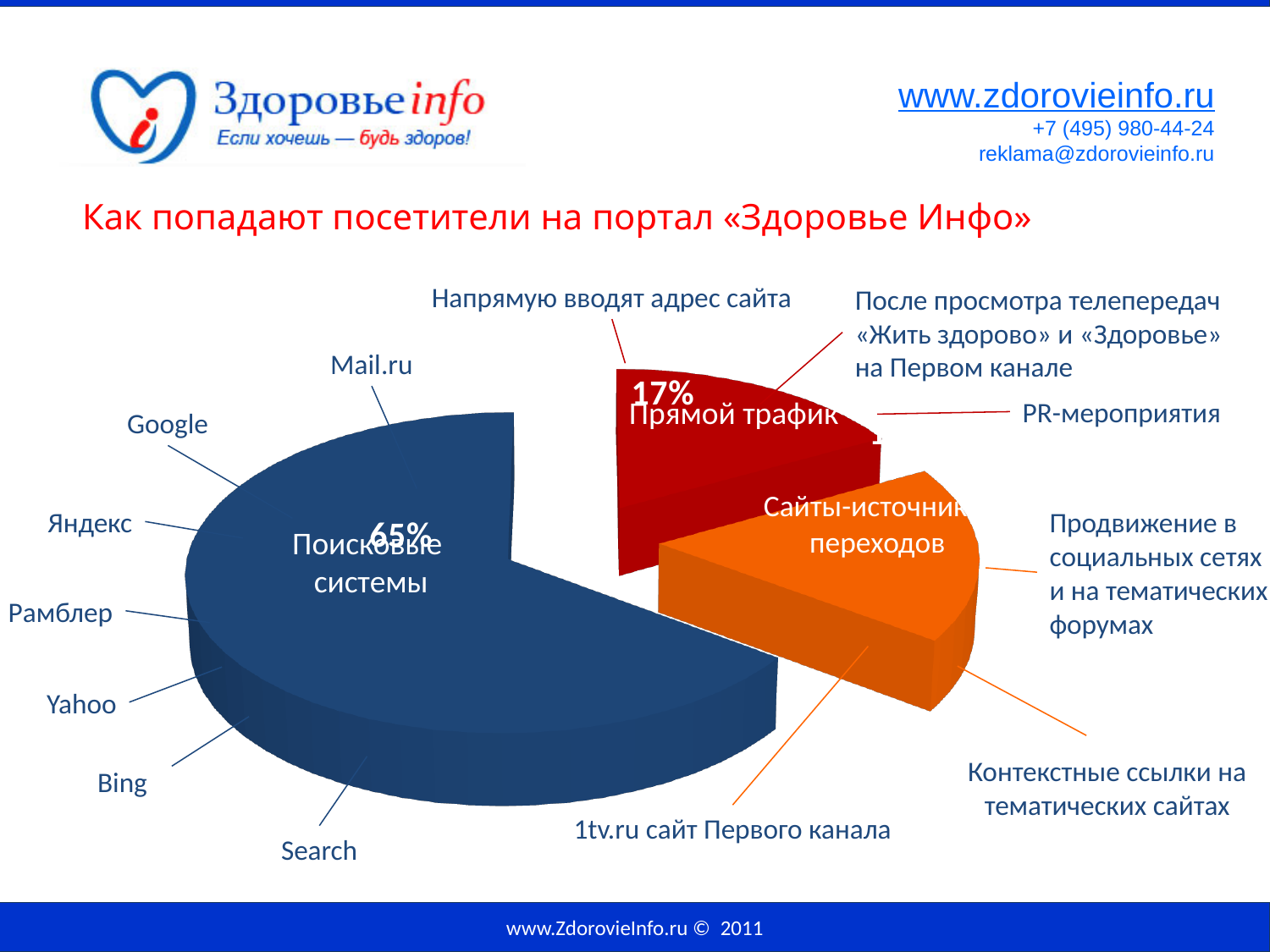
How many slices does the pie chart have? 3 Which slice is coloured red? Прямой трафик Which slice of the pie chart is the largest? Поисковые системы What share of the pie does Поисковые системы take? 65% By how many percentage points does Поисковые системы exceed Прямой трафик? 48 What percentage of visitors come via Прямой трафик? 17% What kind of chart is shown on the slide? pie chart What is the title of the slide's chart? Как попадают посетители на портал «Здоровье Инфо» Which is larger: Поисковые системы or Прямой трафик? Поисковые системы What percentage of visitors come via Поисковые системы? 65% What colour is the Поисковые системы slice? blue